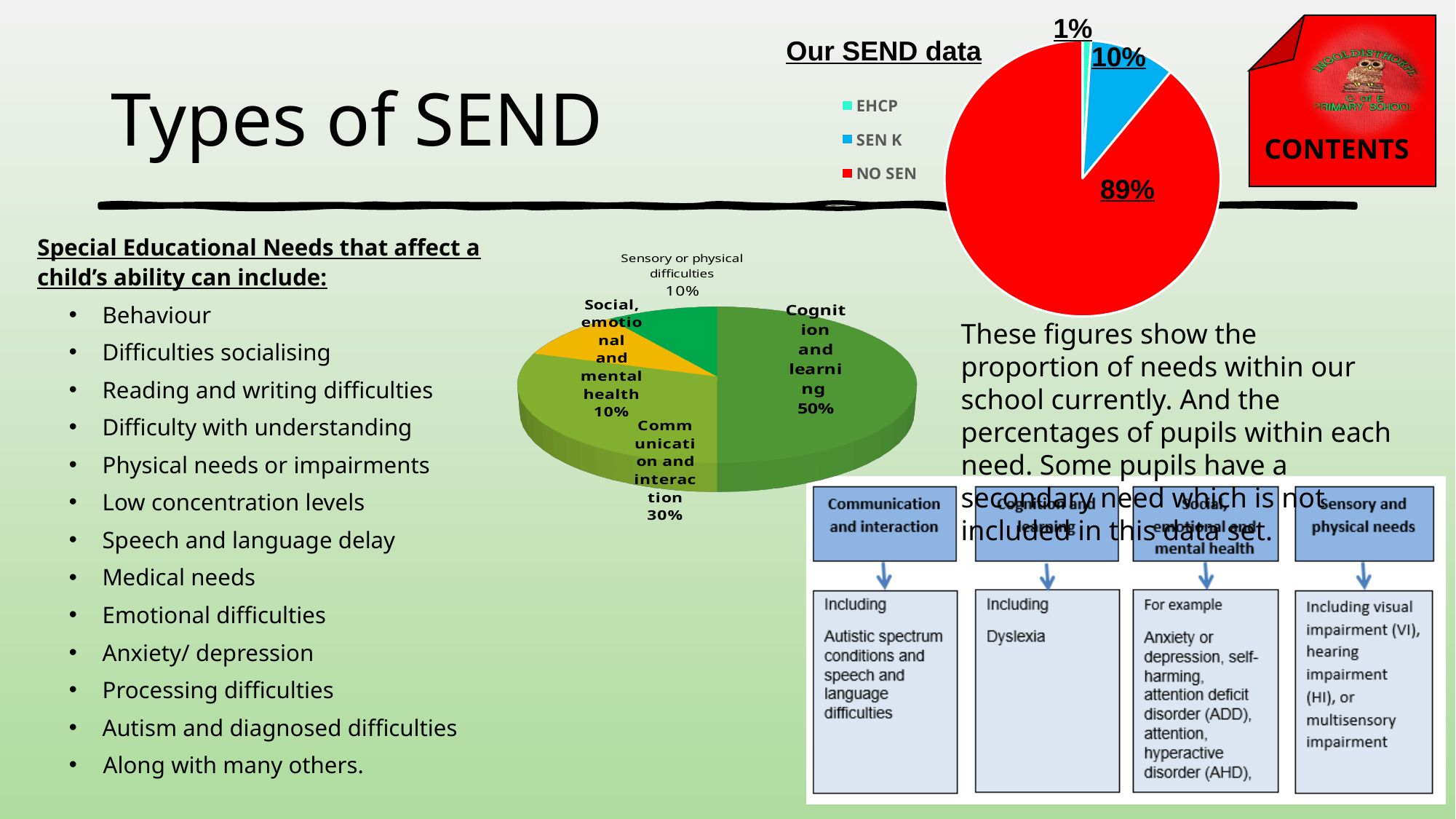
In the 'Our SEND data' pie chart, what percentage of pupils are SEN K? 10% In the 'Our SEND data' pie chart, what is the difference in percentage points between SEN K and EHCP? 9 In the pie chart of types of need in the lower middle of the slide, which category has the largest share? Cognition and learning In the pie chart of types of need in the lower middle of the slide, what percentage is Communication and interaction? 30% In the 'Our SEND data' pie chart, which category has the smallest share? EHCP In the 'Our SEND data' pie chart, how many categories does the legend list? 3 In the 'Our SEND data' pie chart, what percentage of pupils have no SEN? 89% In the pie chart of types of need in the lower middle of the slide, what percentage is Cognition and learning? 50% What kind of chart is the 'Our SEND data' chart? Pie chart In the pie chart of types of need in the lower middle of the slide, how many categories are shown? 4 In the 'Our SEND data' pie chart, which category has the largest share? NO SEN In the 'Our SEND data' pie chart, what percentage of pupils have an EHCP? 1%